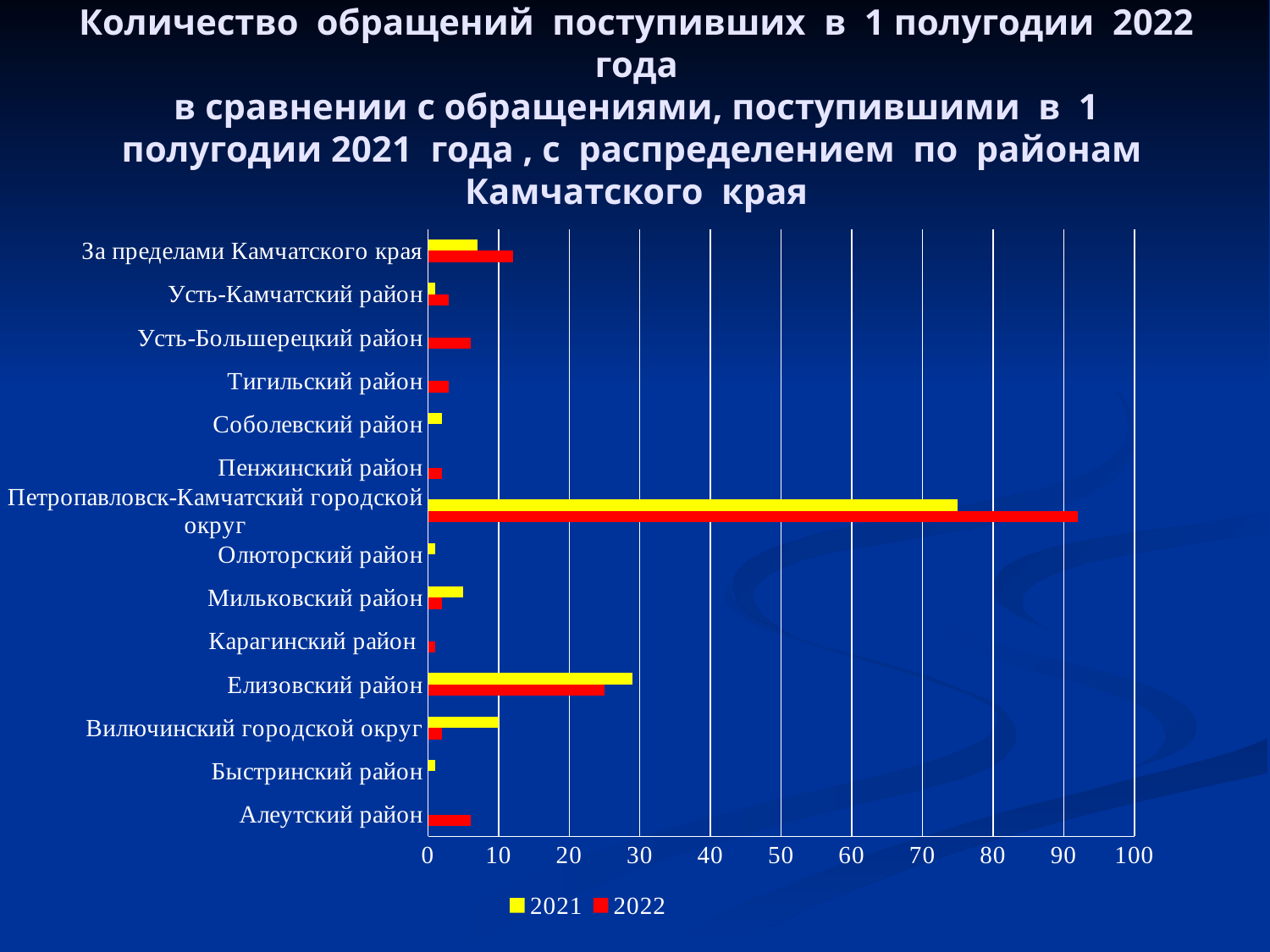
How many series does the legend list? 2 For Елизовский район, which year has the larger value, 2021 or 2022? 2021 Is the 2021 value for Петропавловск-Камчатский городской округ greater or less than 80? less How many districts (categories) are shown on the vertical axis? 14 Is the 2021 value for Елизовский район greater or less than 20? greater Which district has the highest value for 2022? Петропавловск-Камчатский городской округ What colour represents the 2022 series in the legend? red For Петропавловск-Камчатский городской округ, which year has the larger value, 2021 or 2022? 2022 What kind of chart is shown on the slide? bar chart Is the 2022 value for Петропавловск-Камчатский городской округ greater or less than 80? greater Which district has the highest value for 2021? Петропавловск-Камчатский городской округ For За пределами Камчатского края, which year has the larger value, 2021 or 2022? 2022